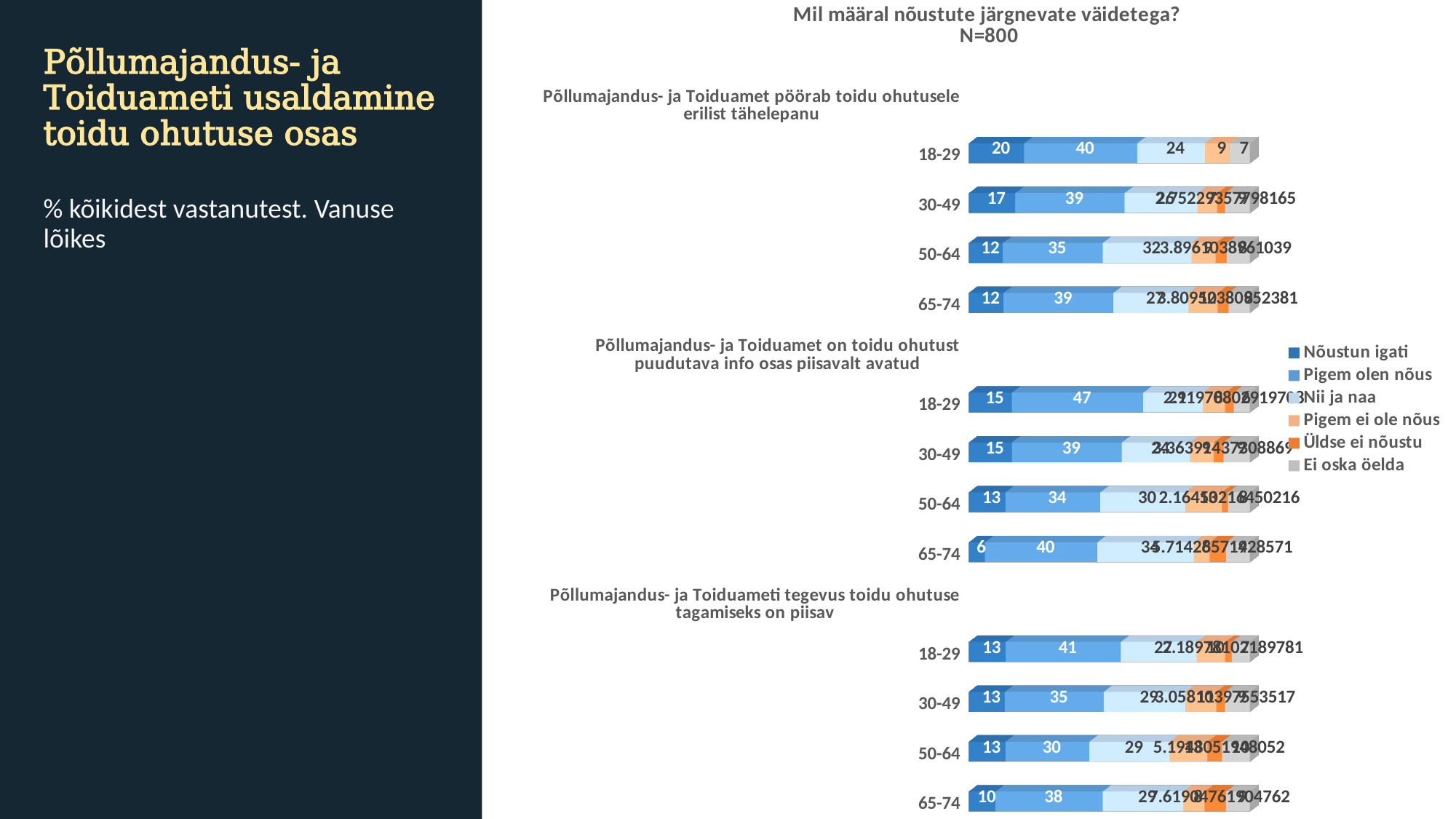
What kind of chart is shown on the slide? Stacked bar chart How many age groups are shown for each statement in the chart? 4 Under the statement "Põllumajandus- ja Toiduamet on toidu ohutust puudutava info osas piisavalt avatud", which age group has the lowest "Nõustun igati" value? 65-74 What is the value of "Nõustun igati" for the 18-29 age group under the statement "Põllumajandus- ja Toiduamet pöörab toidu ohutusele erilist tähelepanu"? 20 Under the statement "Põllumajandus- ja Toiduamet pöörab toidu ohutusele erilist tähelepanu", which age group has the highest "Nõustun igati" value? 18-29 What is the value of "Nii ja naa" for the 18-29 age group under the statement "Põllumajandus- ja Toiduamet pöörab toidu ohutusele erilist tähelepanu"? 24 Under the statement "Põllumajandus- ja Toiduamet on toidu ohutust puudutava info osas piisavalt avatud", which age group has the larger "Pigem olen nõus" value, 18-29 or 30-49? 18-29 Under the statement "Põllumajandus- ja Toiduamet pöörab toidu ohutusele erilist tähelepanu", what is the difference between the "Nõustun igati" values for 18-29 and 30-49? 3 What is the value of "Pigem olen nõus" for the 18-29 age group under the statement "Põllumajandus- ja Toiduamet on toidu ohutust puudutava info osas piisavalt avatud"? 47 What is the value of "Nõustun igati" for the 65-74 age group under the statement "Põllumajandus- ja Toiduamet on toidu ohutust puudutava info osas piisavalt avatud"? 6 How many series does the chart legend list? 6 What is the value of "Pigem olen nõus" for the 65-74 age group under the statement "Põllumajandus- ja Toiduameti tegevus toidu ohutuse tagamiseks on piisav"? 38